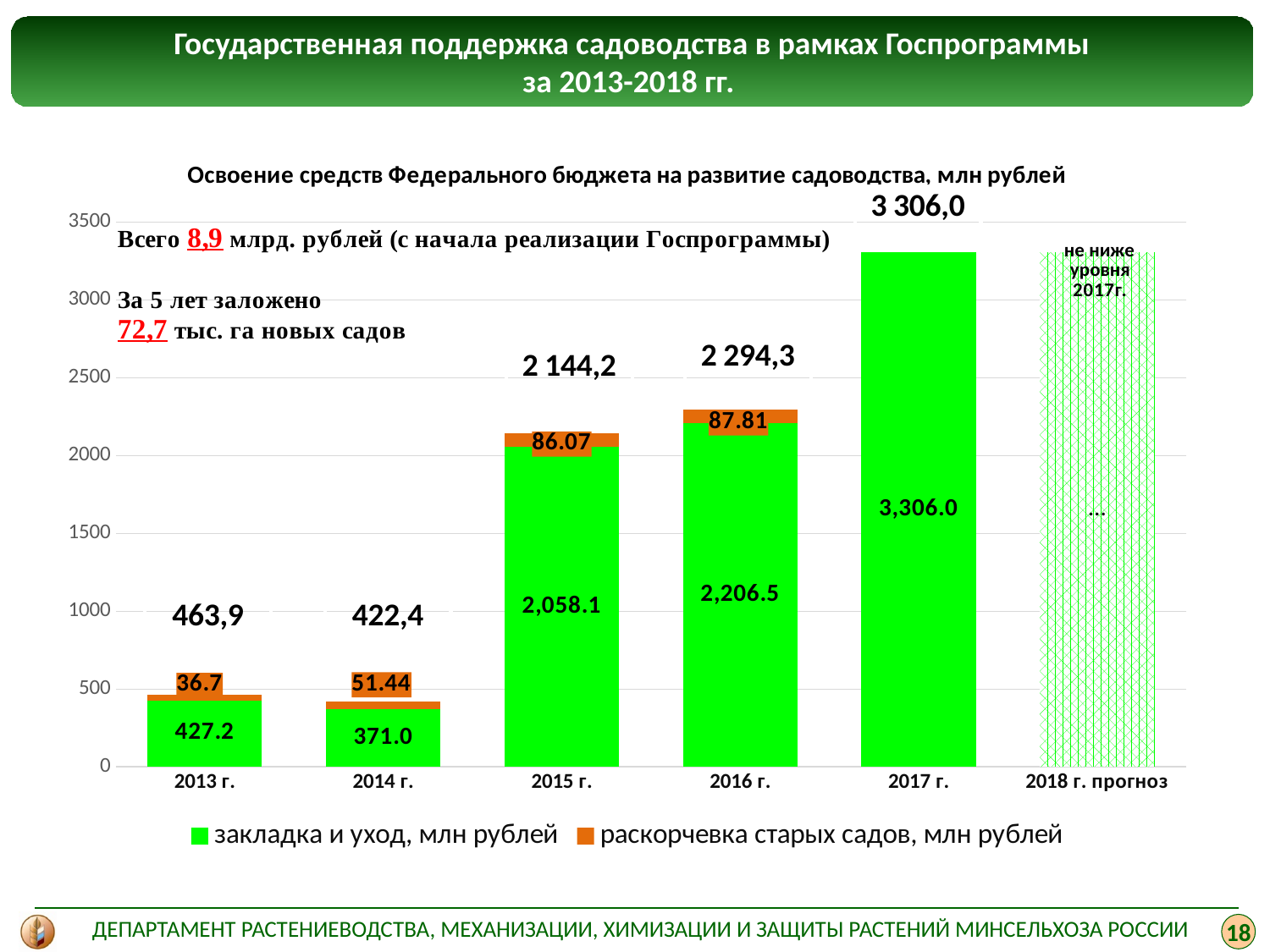
What type of chart is shown on the slide? stacked bar chart What is the difference between the раскорчевка старых садов values for 2014 г. and 2013 г.? 14.74 How many series does the legend list? 2 What is the value of закладка и уход, млн рублей for 2015 г.? 2,058.1 Is the total value for 2017 г. greater or less than 3000? greater Which year has the highest total value? 2017 г. What is the title of the chart? Освоение средств Федерального бюджета на развитие садоводства, млн рублей What is the value of закладка и уход, млн рублей for 2014 г.? 371.0 Which year has the lowest total value? 2014 г. Which is larger: the закладка и уход value for 2016 г. or for 2015 г.? 2016 г. What is the value of раскорчевка старых садов, млн рублей for 2016 г.? 87.81 What is the total shown above the bar for 2016 г.? 2 294,3